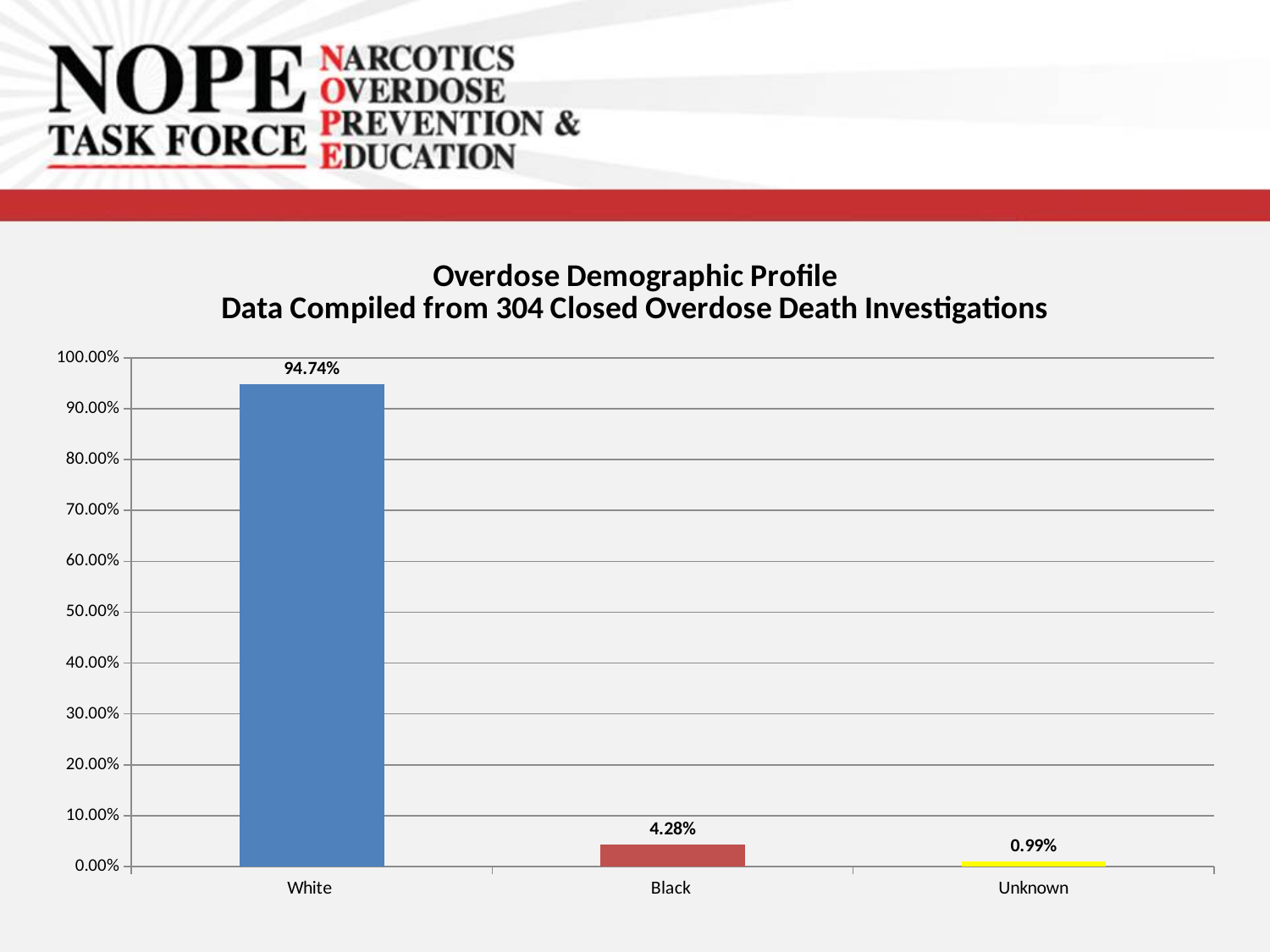
What is the difference between the values for White and Black? 90.46% Which category has the highest value? White What is the value for Unknown? 0.99% Which is larger, the value for Black or the value for Unknown? Black What is the title of the chart? Overdose Demographic Profile Data Compiled from 304 Closed Overdose Death Investigations What kind of chart is shown on the slide? bar chart Is the value for White greater or less than 90.00%? greater How many categories are shown on the x axis? 3 What is the value for Black? 4.28% Which category has the lowest value? Unknown What is the difference between the values for Black and Unknown? 3.29% What is the value for White? 94.74%